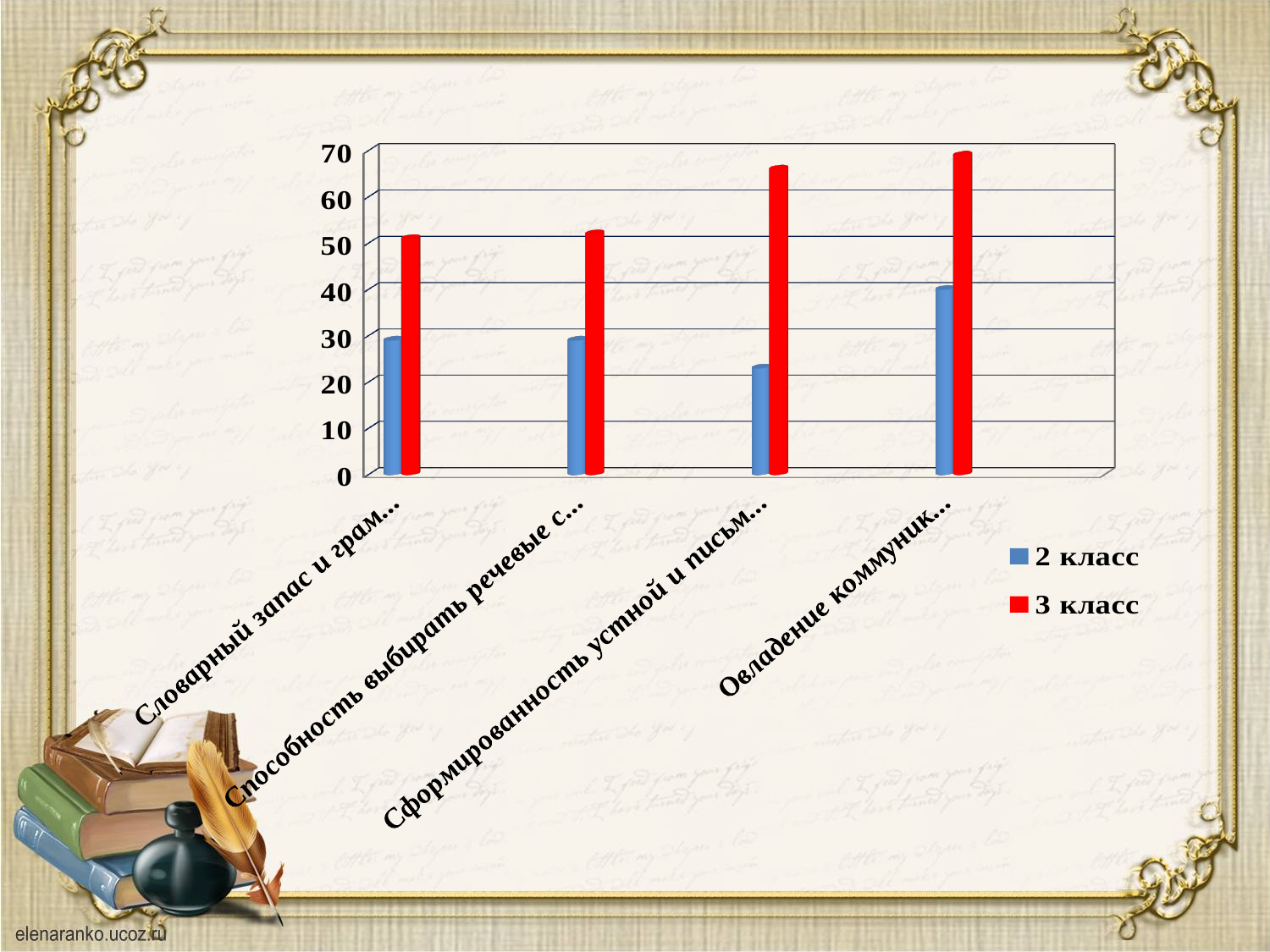
What kind of chart is shown on the slide? bar chart What colour are the bars for the series "3 класс"? red Which category has the lowest value for the series "2 класс"? the third category (Сформированность устной и письм...) Do the "3 класс" values generally rise or fall from the first category to the fourth? rise Which category has the highest value for the series "2 класс"? the fourth category (Овладение коммуник...) How many categories are plotted along the x axis? 4 What are the two entries in the legend? 2 класс and 3 класс Is the "3 класс" value for the third category (Сформированность устной и письм...) greater or less than 60? greater In the first category (Словарный запас и грам...), which series has the larger value, "2 класс" or "3 класс"? 3 класс Is the "3 класс" value for the first category (Словарный запас и грам...) greater or less than 60? less How many series does the legend list? 2 Is the "2 класс" value for the third category (Сформированность устной и письм...) greater or less than 30? less